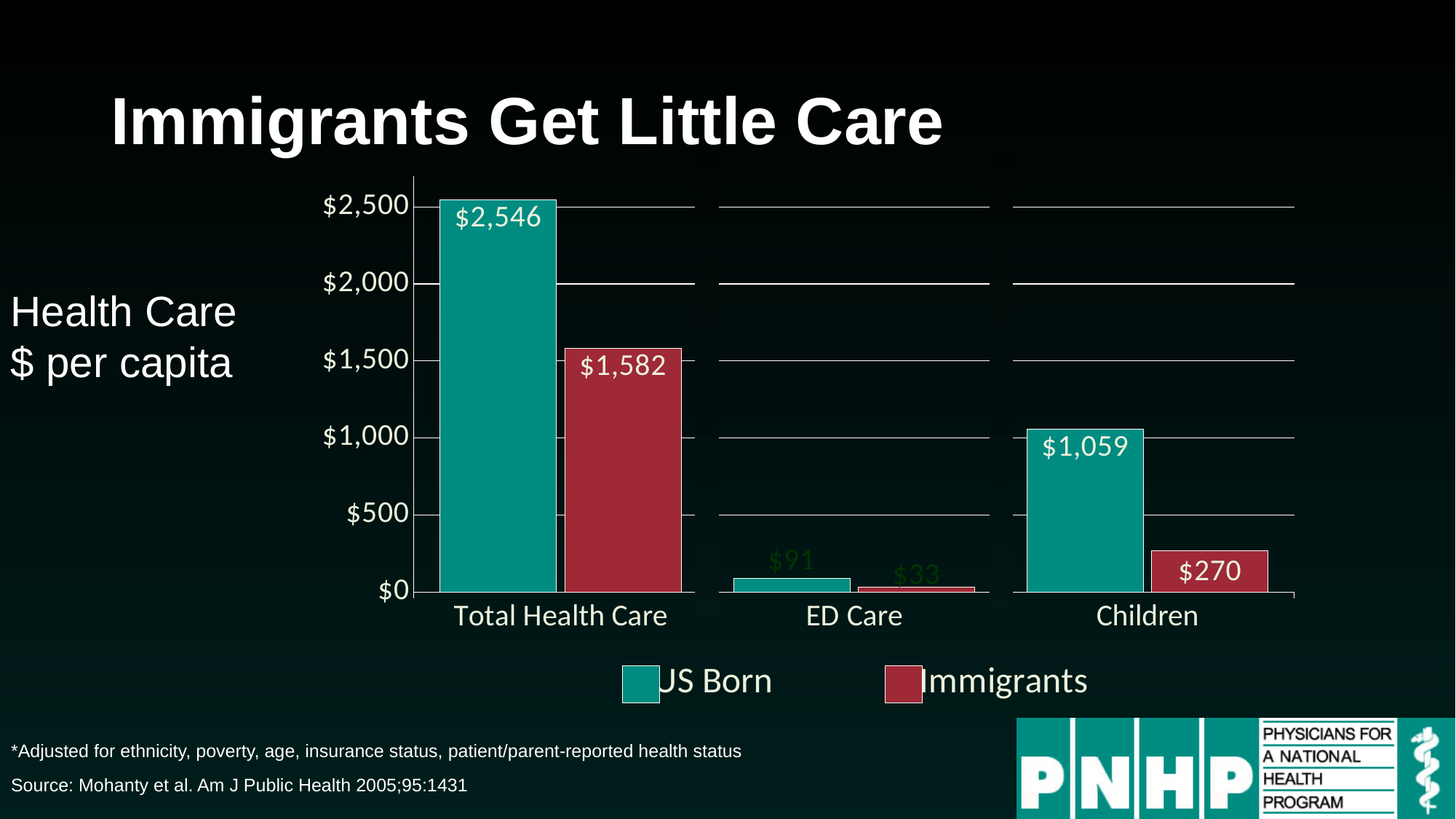
Which category has the lowest value for Immigrants? ED Care How many series does the legend list? 2 What is the difference between the US Born and Immigrants values in the Total Health Care category? $964 How many categories are shown on the x axis? 3 What is the value for US Born in the Total Health Care category? $2,546 What is the difference between the US Born and Immigrants values in the Children category? $789 Which is larger in the ED Care category, the US Born value or the Immigrants value? US Born What is the value for Immigrants in the Children category? $270 What is the value for Immigrants in the Total Health Care category? $1,582 What kind of chart is shown on the slide? Bar chart Which category has the highest value for US Born? Total Health Care What is the value for US Born in the Children category? $1,059